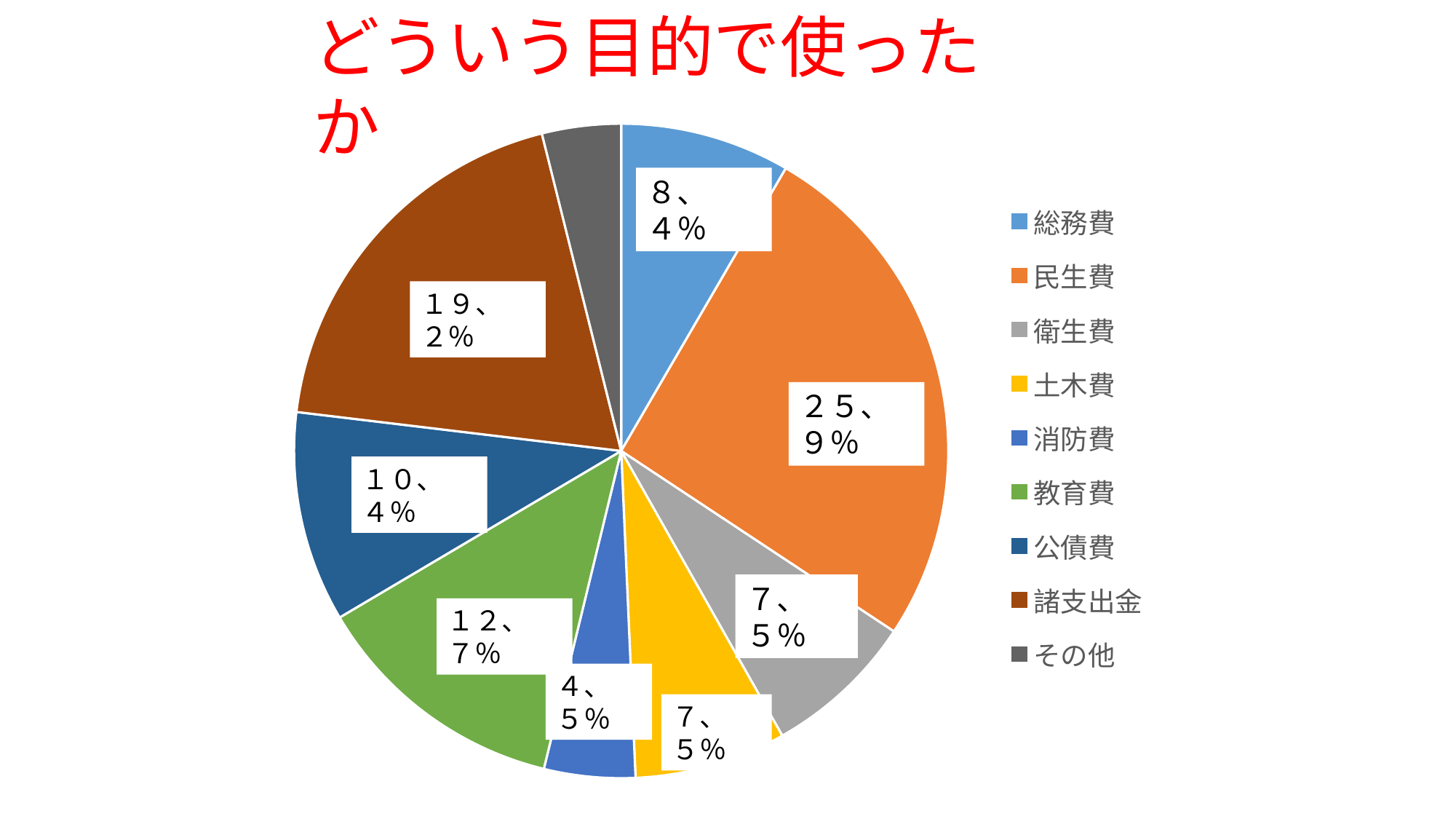
What colour is the slice for 民生費? orange Which is larger, the slice for 諸支出金 or the slice for 教育費? 諸支出金 What is the value shown for 公債費? １０、４％ What is the title of the chart? どういう目的で使ったか What is the value shown for 教育費? １２、７％ What is the value shown for 諸支出金? １９、２％ Which category has the largest slice of the pie? 民生費 How many categories does the legend of the pie chart list? 9 What is the value shown for 消防費? ４、５％ What kind of chart is shown on the slide? pie chart What is the value shown for 民生費? ２５、９％ What is the value shown for 総務費? ８、４％